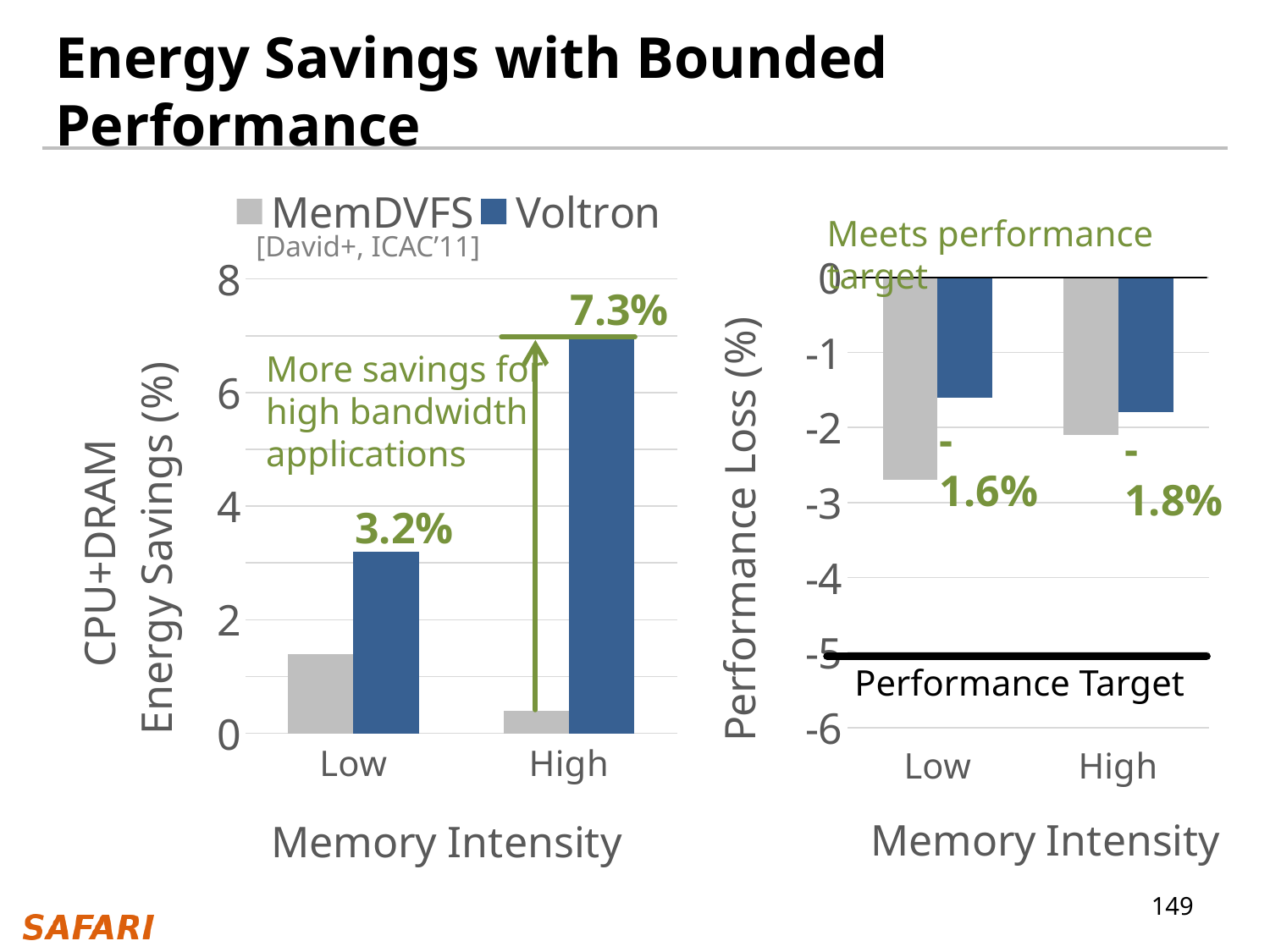
In the left chart (CPU+DRAM Energy Savings), is the MemDVFS value for Low memory intensity greater or less than 2? less In the left chart (CPU+DRAM Energy Savings), what is the difference between the Voltron values for High and Low memory intensity? 4.1% In the left chart (CPU+DRAM Energy Savings), what is the Voltron value for Low memory intensity? 3.2% In the left chart (CPU+DRAM Energy Savings), what is the Voltron value for High memory intensity? 7.3% In the right chart (Performance Loss), what is the Voltron value for High memory intensity? -1.8% In the right chart (Performance Loss), how many memory intensity categories are shown on the x axis? 2 How many series does the legend list for the charts on the slide? 2 In the left chart (CPU+DRAM Energy Savings), which memory intensity has the higher Voltron energy savings? High What kind of chart is the left chart (CPU+DRAM Energy Savings)? bar chart In the right chart (Performance Loss), what is the Voltron value for Low memory intensity? -1.6% In the right chart (Performance Loss), is the MemDVFS value for Low memory intensity greater or less than -2? less In the left chart (CPU+DRAM Energy Savings), which series has the larger value for High memory intensity, MemDVFS or Voltron? Voltron